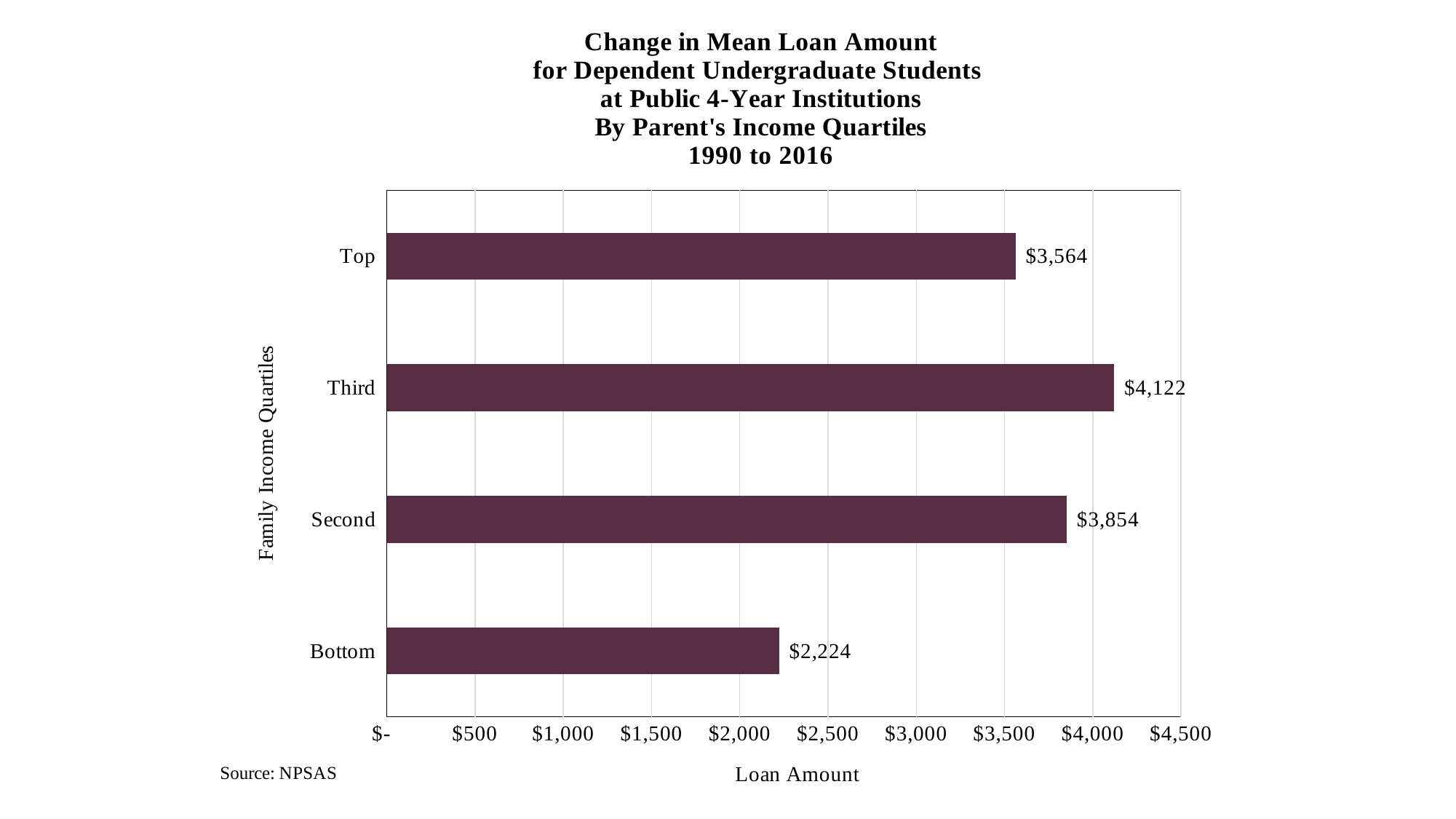
Which income quartile has the smallest change in mean loan amount? Bottom How many income quartiles are shown in the chart? 4 What is the difference between the change in mean loan amount for the Third quartile and the Bottom quartile? $1,898 What is the change in mean loan amount for the Bottom income quartile? $2,224 What is the change in mean loan amount for the Top income quartile? $3,564 What is the label of the horizontal axis? Loan Amount Which income quartile has the largest change in mean loan amount? Third Which has a larger change in mean loan amount, the Second quartile or the Top quartile? Second What kind of chart is shown on the slide? Bar chart What is the change in mean loan amount for the Second income quartile? $3,854 What is the difference between the change in mean loan amount for the Second quartile and the Top quartile? $290 Is the value for the Third quartile greater or less than $4,000? greater